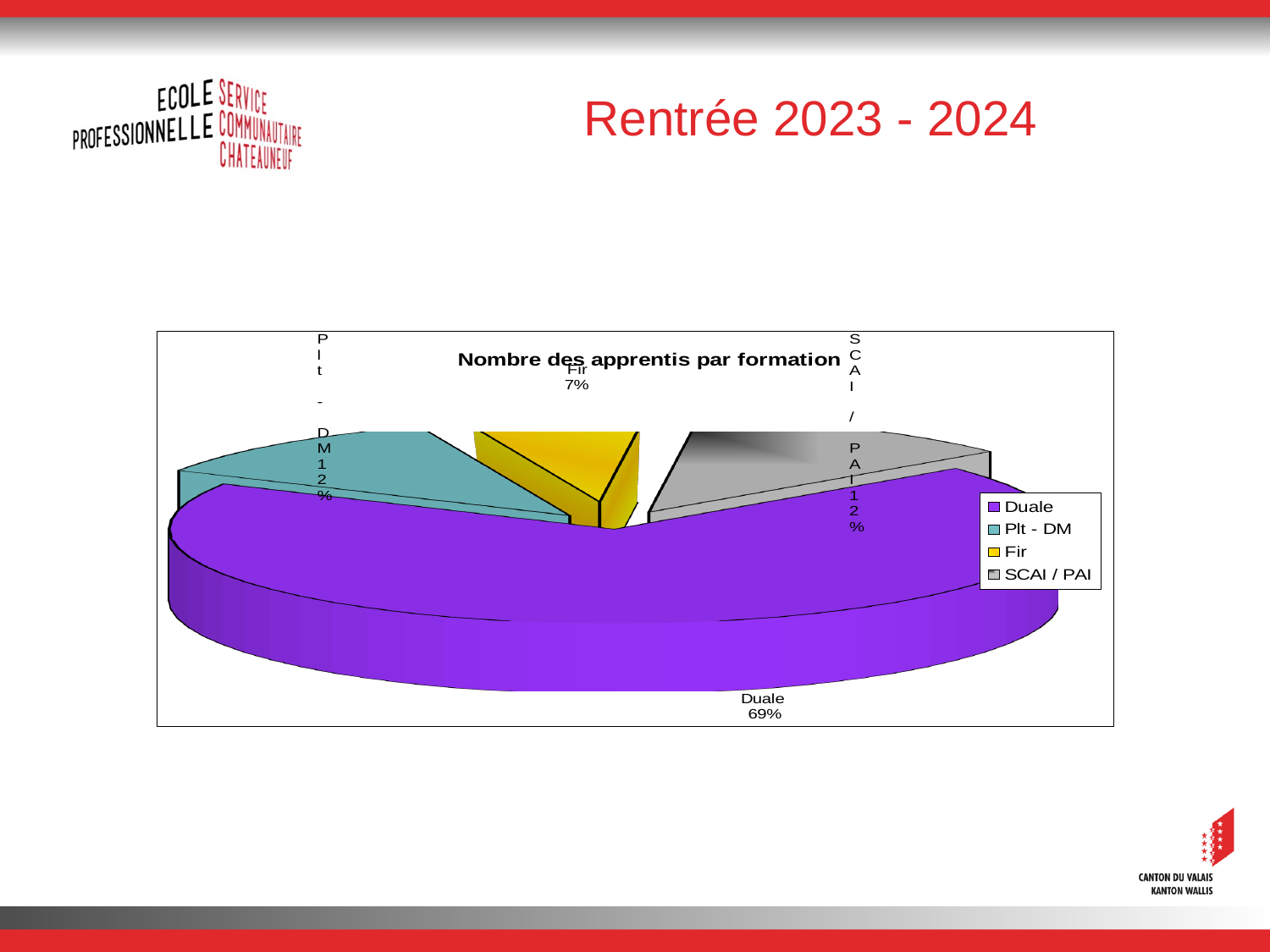
What is the title of the chart? Nombre des apprentis par formation How many entries does the legend list? 4 What type of chart is shown on the slide? Pie chart What share of the pie does the SCAI / PAI slice represent? 12% What share of the pie does the Fir slice represent? 7% How many slices does the pie chart have? 4 Which category has the smallest slice of the pie? Fir What is the difference between the share for Duale and the share for Fir? 62% Which is larger, the share for Duale or the share for Fir? Duale Which category has the largest slice of the pie? Duale What share of the pie does the Duale slice represent? 69%